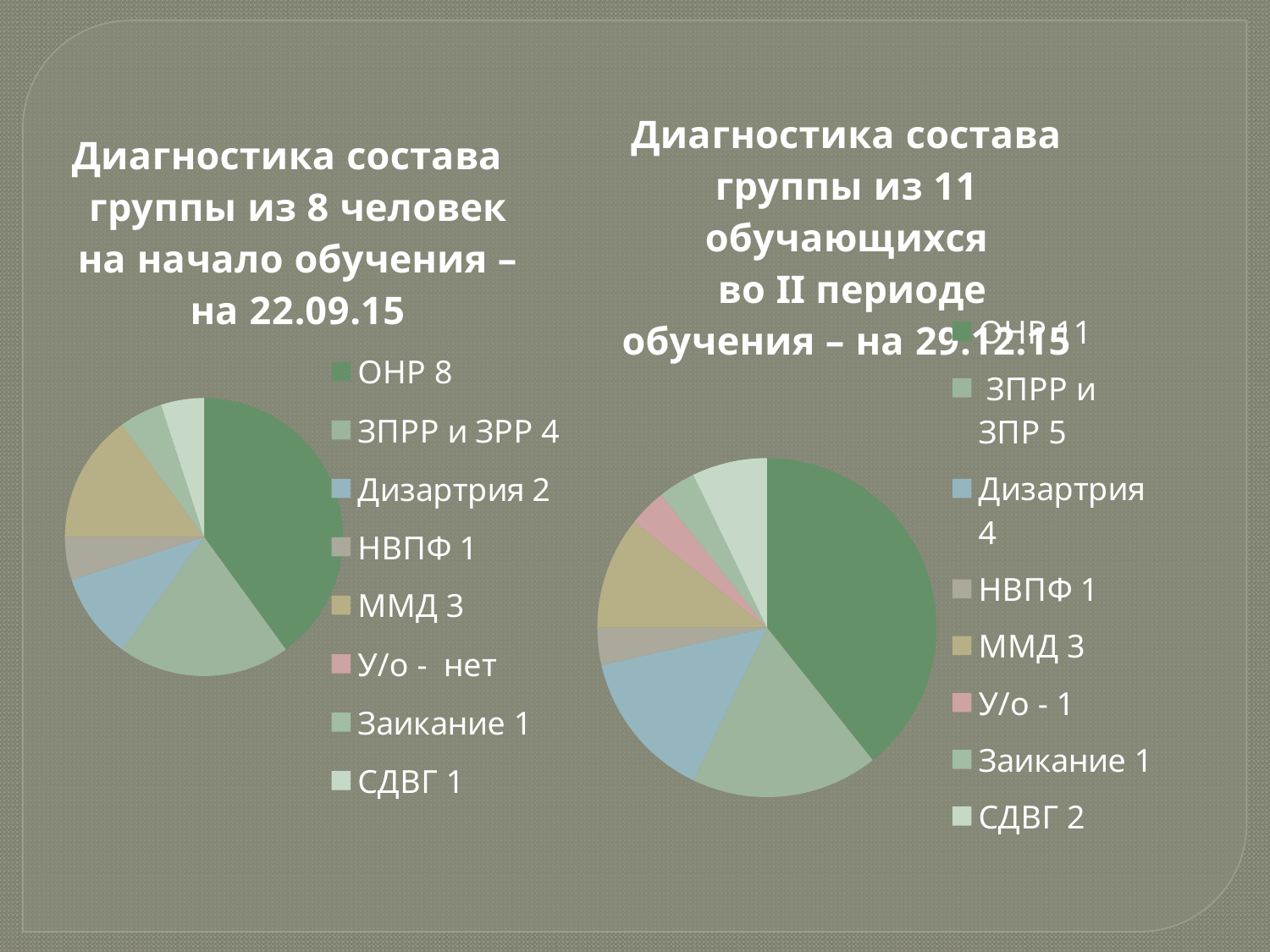
How many entries does the legend of the left chart (group of 8 on 22.09.15) list? 8 How many entries does the legend of the right chart (group of 11 on 29.12.15) list? 8 In the left chart (group of 8 on 22.09.15), what value is given for ММД? 3 In the left chart (group of 8 on 22.09.15), what is the difference between ОНР and ЗПРР и ЗРР? 4 In the right chart (group of 11 on 29.12.15), what is the difference between Дизартрия and ММД? 1 In the right chart (group of 11 on 29.12.15), what value is given for Дизартрия? 4 In the right chart (group of 11 on 29.12.15), what value is given for СДВГ? 2 In the left chart (group of 8 on 22.09.15), what value is given for Дизартрия? 2 What kind of chart is the left chart, 'Диагностика состава группы из 8 человек'? pie chart In the left chart (group of 8 on 22.09.15), what is shown for У/о? нет In the left chart (group of 8 on 22.09.15), which category has the largest value? ОНР 8 In the right chart (group of 11 on 29.12.15), which is larger: ЗПРР и ЗПР or Дизартрия? ЗПРР и ЗПР